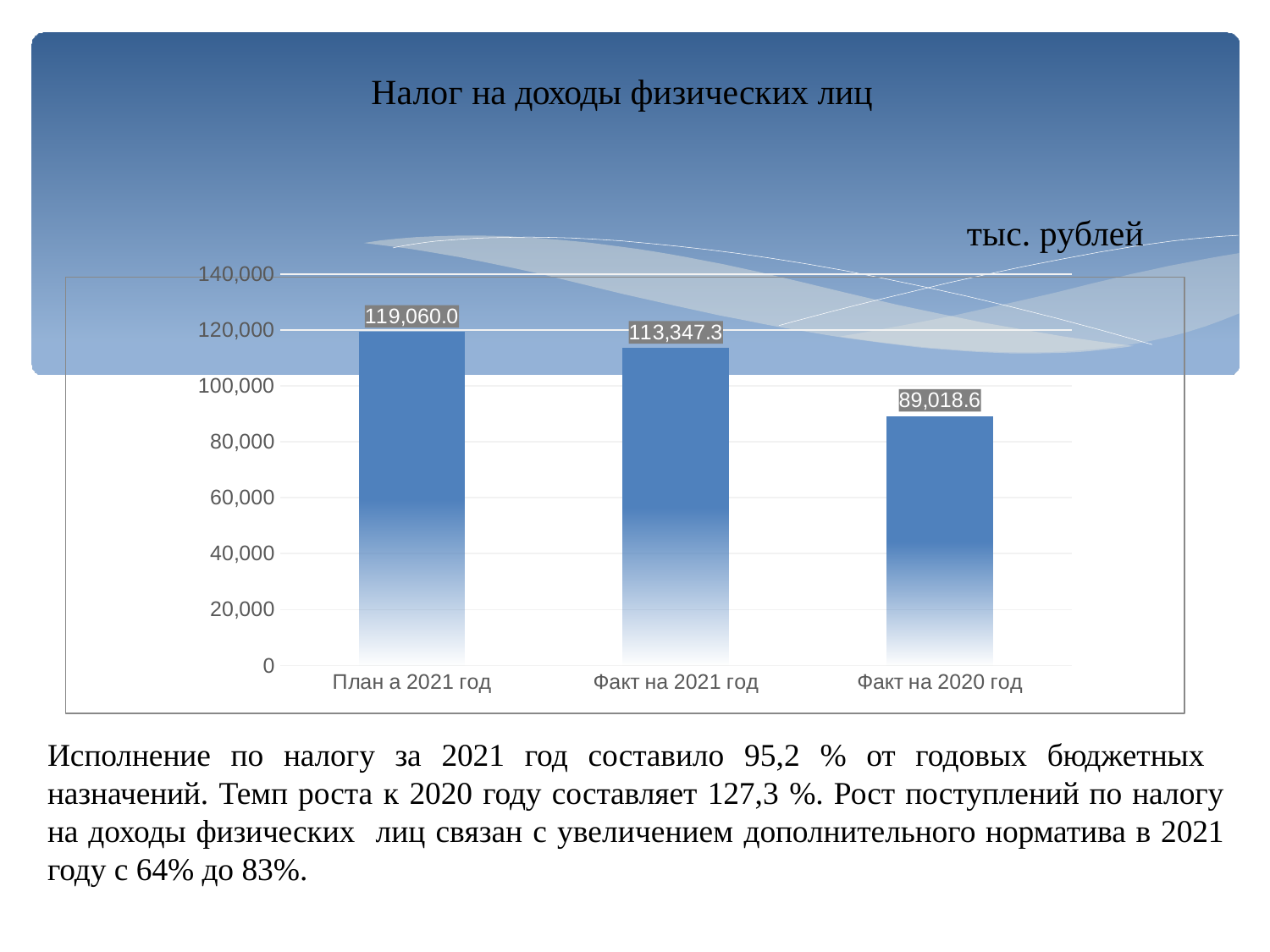
Which category has the lowest value? Факт на 2020 год Which is larger, Факт на 2021 год or Факт на 2020 год? Факт на 2021 год What is the difference between Факт на 2021 год and Факт на 2020 год? 24,328.7 What is the title of the chart? Налог на доходы физических лиц How many categories are shown on the chart? 3 What is the value for Факт на 2020 год? 89,018.6 What kind of chart is shown on the slide? bar chart Which category has the highest value? План а 2021 год What is the difference between План а 2021 год and Факт на 2021 год? 5,712.7 What is the value for Факт на 2021 год? 113,347.3 What is the value for План а 2021 год? 119,060.0 Is the value for Факт на 2020 год greater or less than 100,000? less